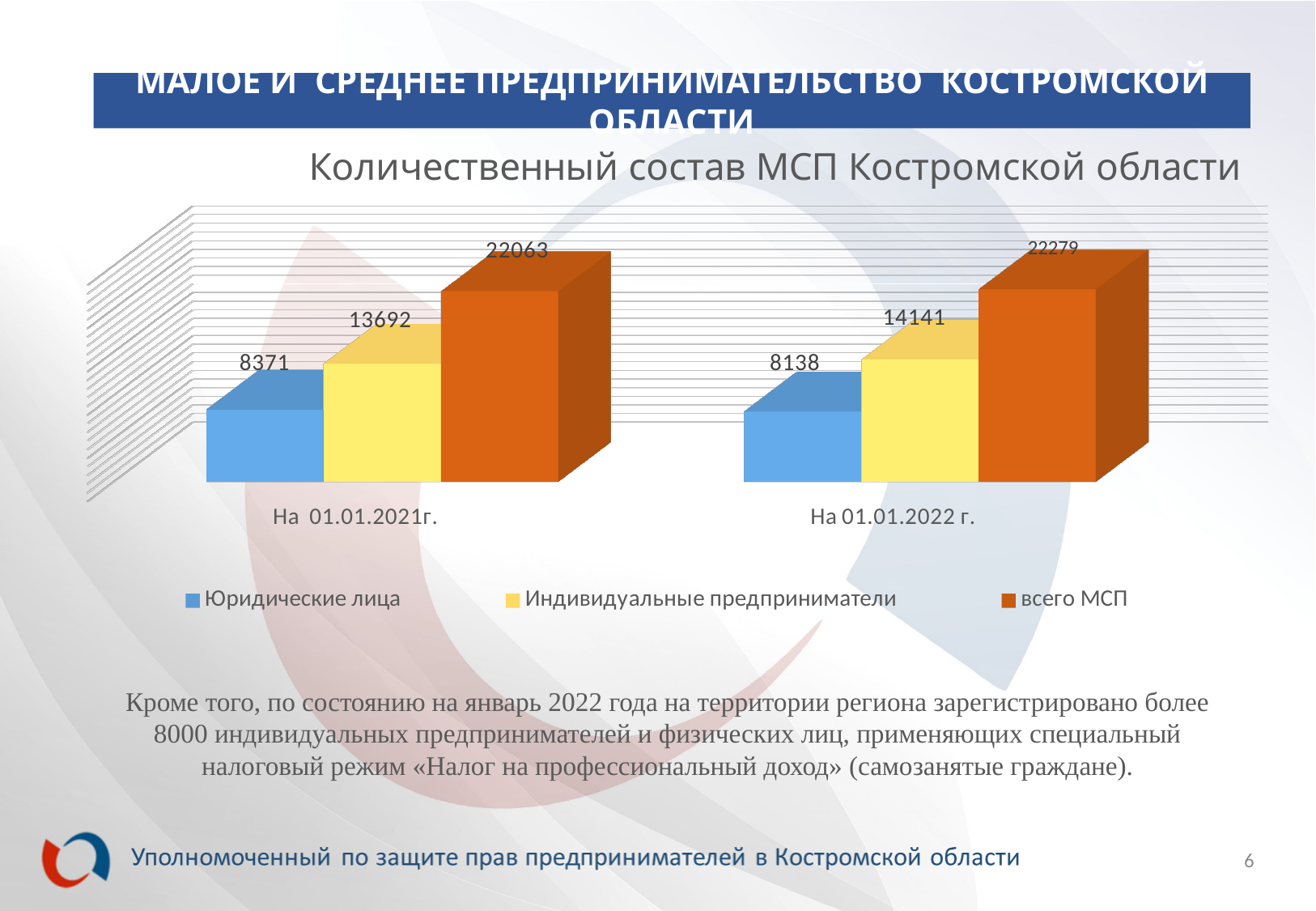
What kind of chart is shown? bar chart Which series has the lowest value on 01.01.2021? Юридические лица What is the difference between всего МСП on 01.01.2022 and on 01.01.2021? 216 Which is larger: Юридические лица on 01.01.2021 or on 01.01.2022? 01.01.2021 Which series has the highest value on 01.01.2022? всего МСП What is the value for всего МСП on 01.01.2022? 22279 What is the title of the chart? Количественный состав МСП Костромской области What is the value for Индивидуальные предприниматели on 01.01.2022? 14141 What is the value for всего МСП on 01.01.2021? 22063 What is the value for Юридические лица on 01.01.2021? 8371 What is the difference between Индивидуальные предприниматели and Юридические лица on 01.01.2021? 5321 How many series does the legend list? 3